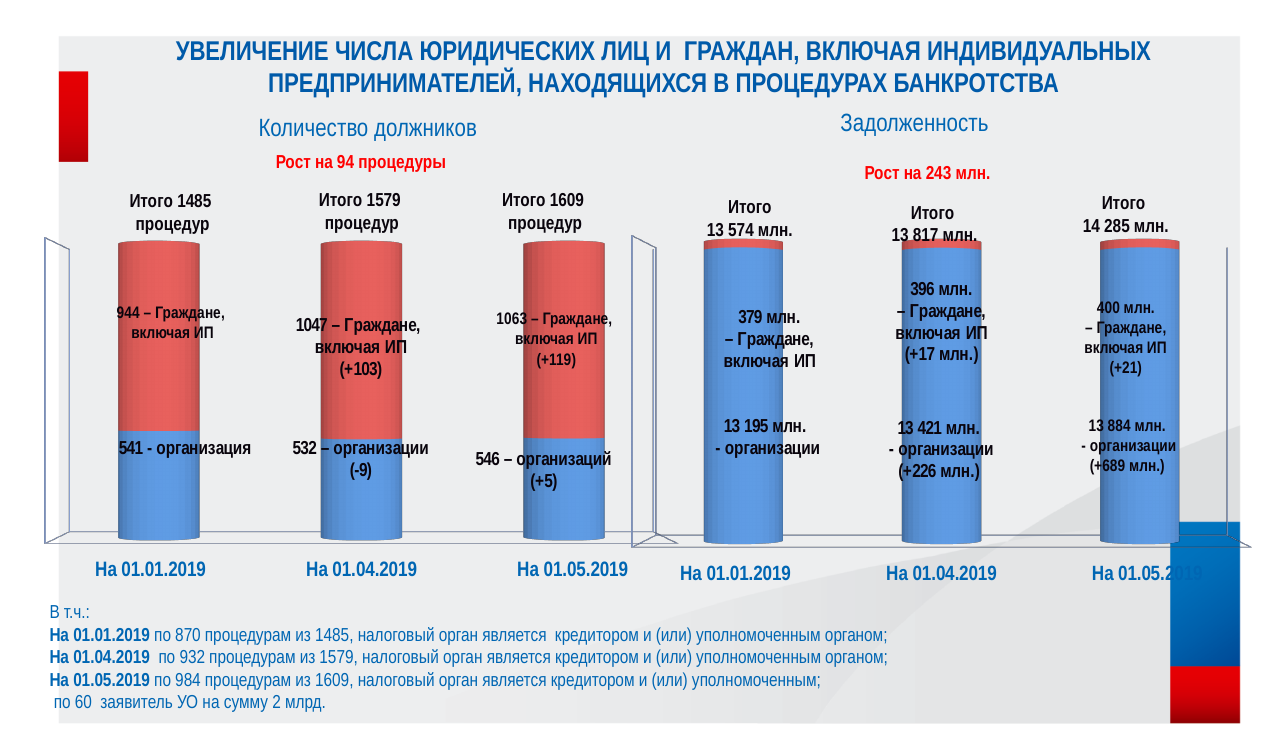
On the "Задолженность" chart, what is the total (Итого) for 01.05.2019? 14 285 млн. On the "Задолженность" chart, which date has the lowest total? На 01.01.2019 On the "Задолженность" chart, do the totals rise or fall from 01.01.2019 to 01.05.2019? rise How many bars does the "Количество должников" chart show? 3 On the "Количество должников" chart, which date has the highest total? На 01.05.2019 On the "Задолженность" chart, what is the debt of citizens including individual entrepreneurs on 01.01.2019? 379 млн. On the "Количество должников" chart, what is the total (Итого) for 01.01.2019? 1485 процедур On the "Задолженность" chart, what is the debt of organizations on 01.04.2019? 13 421 млн. What type of chart is used on the slide? bar chart On the "Количество должников" chart, what is the value for citizens including individual entrepreneurs (Граждане, включая ИП) on 01.05.2019? 1063 On the "Количество должников" chart, how many organizations (организации) are shown for 01.04.2019? 532 On the "Количество должников" chart, what is the difference between the totals for 01.05.2019 and 01.01.2019? 124